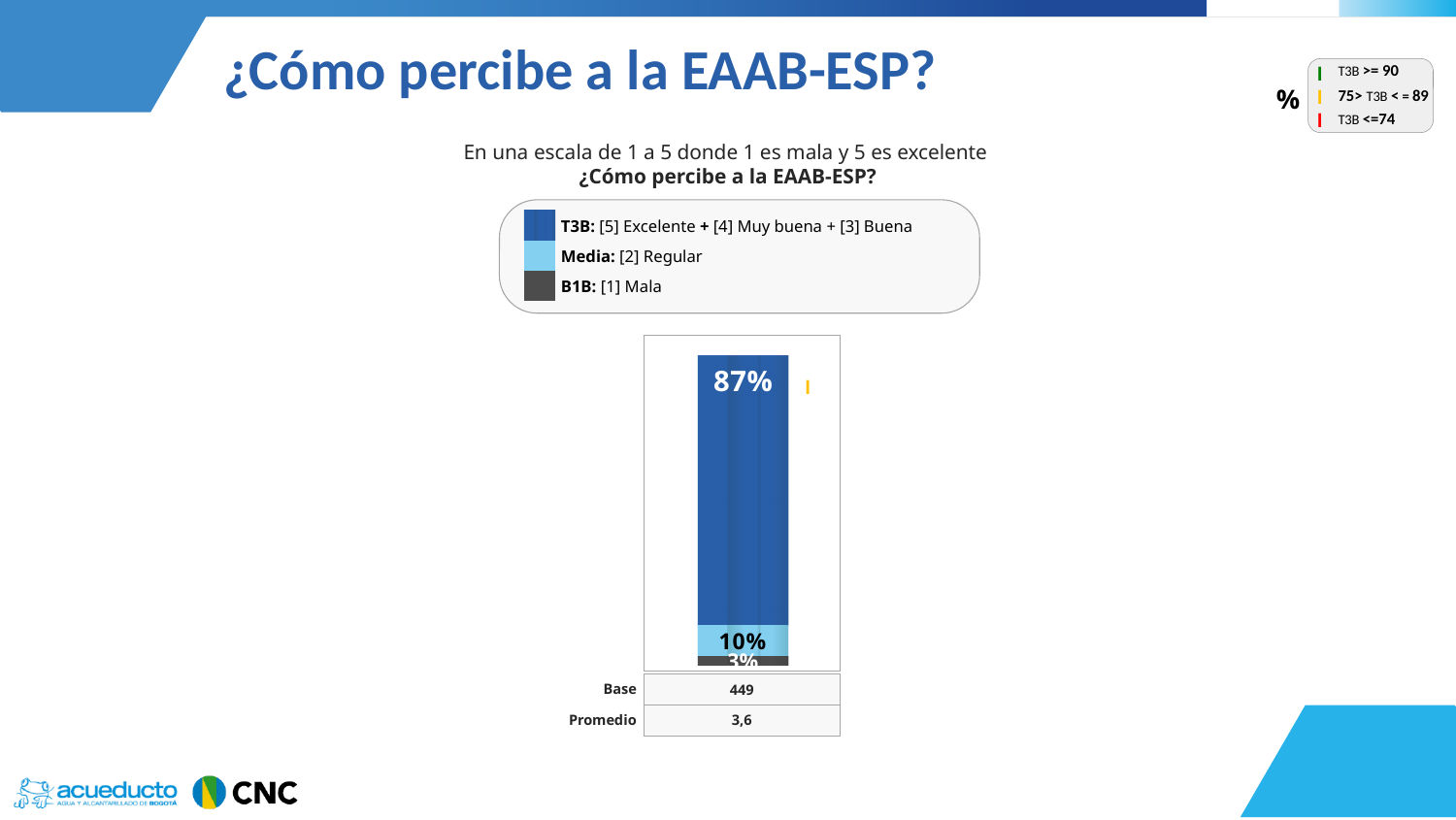
What kind of chart is shown on the slide? Stacked bar chart Which is larger, the T3B segment or the Media segment? T3B What is the Promedio (average) value shown below the chart? 3,6 What percentage is shown for the Media ([2] Regular) segment of the bar? 10% What is the difference between the T3B segment and the Media segment? 77% Which segment of the stacked bar has the highest value? T3B What is the Base value shown below the chart? 449 According to the legend, which response categories are combined into T3B? [5] Excelente + [4] Muy buena + [3] Buena How many segments make up the stacked bar? 3 Which segment of the stacked bar has the lowest value? B1B Which colour represents the T3B segment in the legend? Dark blue What percentage of respondents fall in the T3B (Excelente + Muy buena + Buena) segment of the bar? 87%